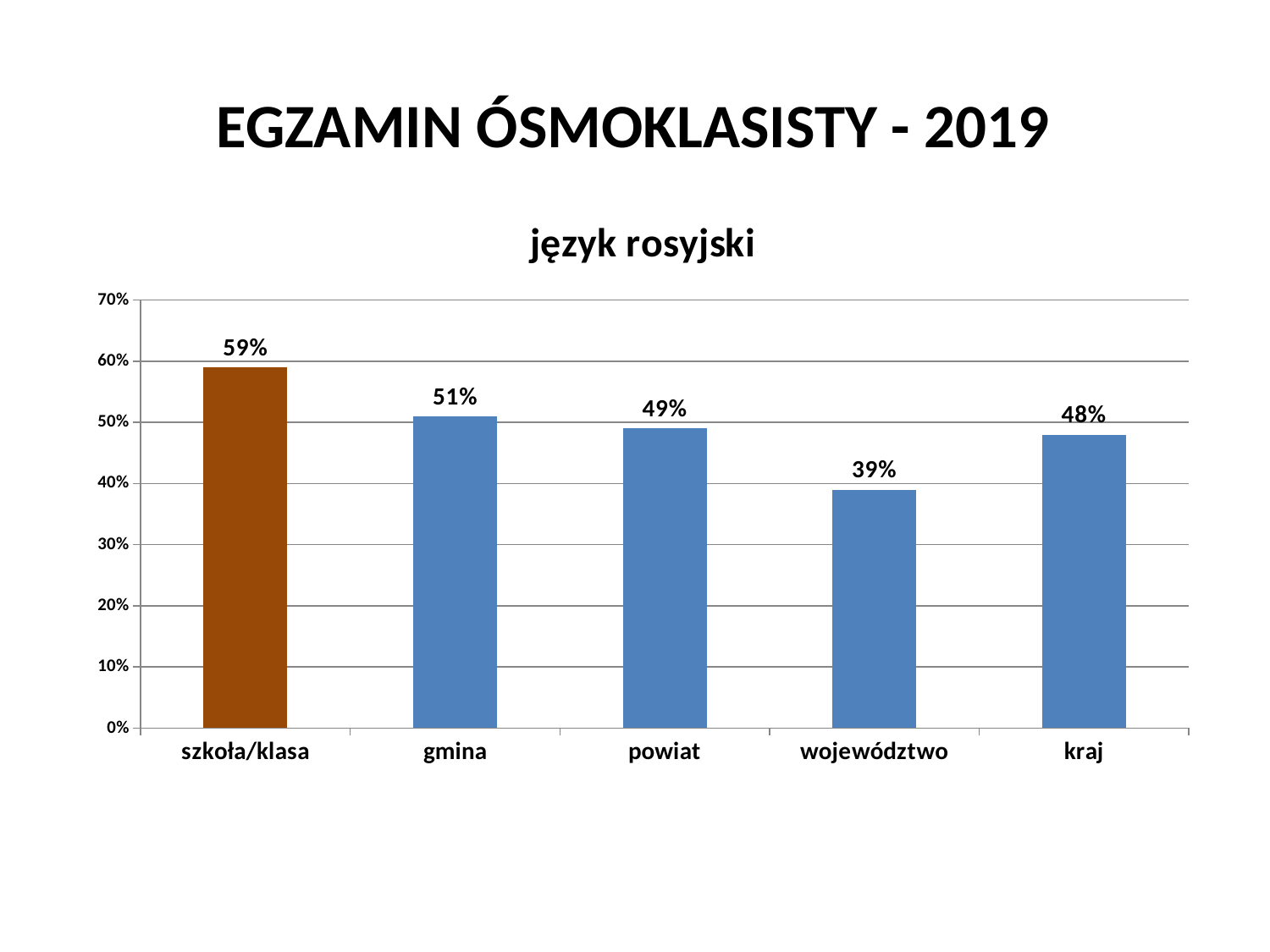
What is the value for szkoła/klasa? 59% What is the difference between the values for szkoła/klasa and kraj? 11% What is the difference between the values for powiat and województwo? 10% What is the value for gmina? 51% What kind of chart is shown on the slide? bar chart How many categories are shown on the x axis? 5 Which is larger, the value for gmina or the value for kraj? gmina What is the title of the chart? język rosyjski What is the value for kraj? 48% Which category has the highest value? szkoła/klasa What is the value for województwo? 39% Which category has the lowest value? województwo